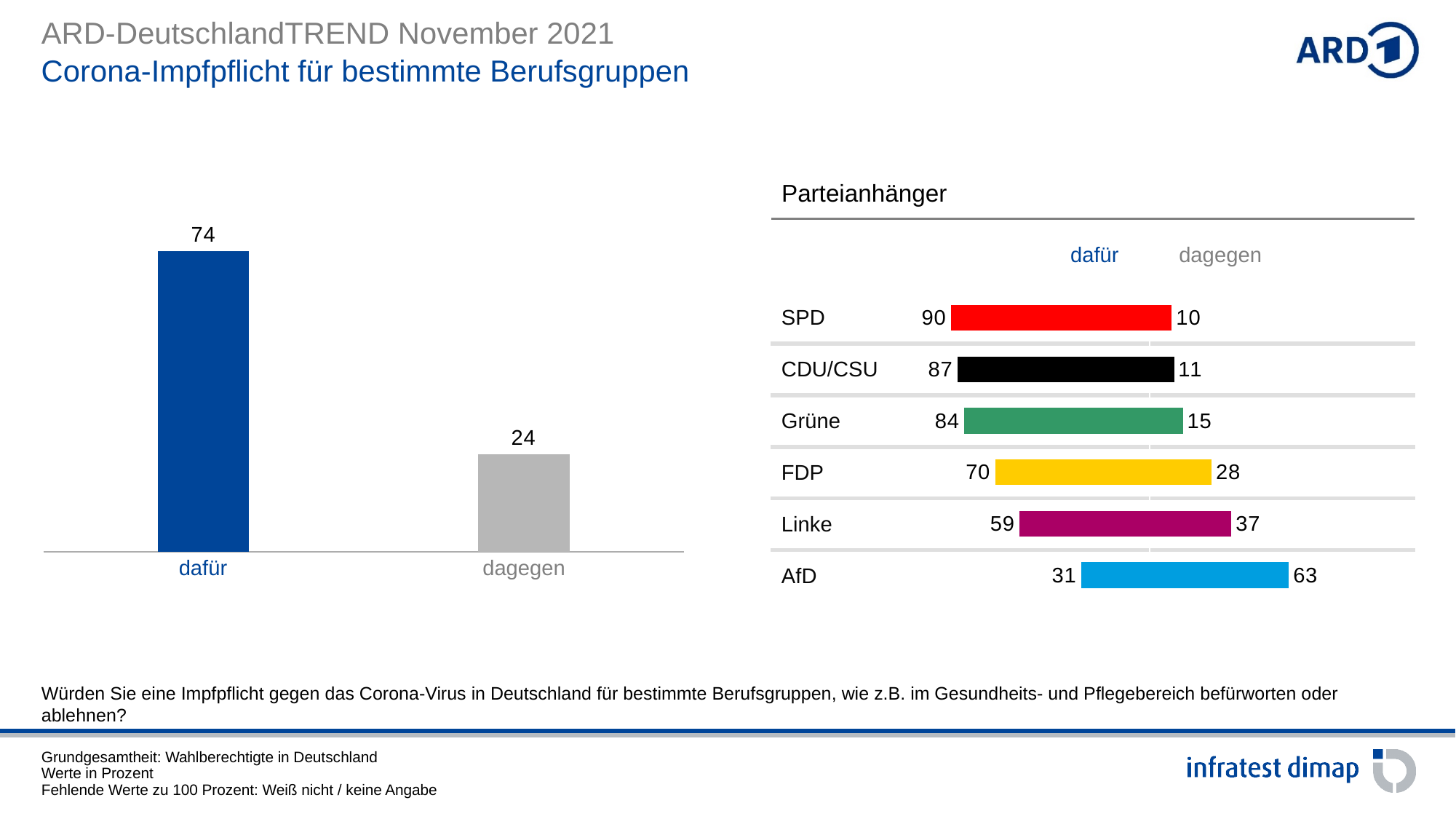
In the 'Parteianhänger' chart, is the 'dafür' value for FDP or for Grüne larger? Grüne In the left bar chart, what is the difference between the 'dafür' and 'dagegen' values? 50 In the 'Parteianhänger' chart, which party has the highest 'dafür' value? SPD What kind of chart is the chart on the left of the slide? bar chart In the 'Parteianhänger' chart, what is the 'dafür' value for SPD? 90 In the 'Parteianhänger' chart, what is the 'dagegen' value for CDU/CSU? 11 In the left bar chart, what is the value for 'dagegen'? 24 In the 'Parteianhänger' chart, which party has the lowest 'dafür' value? AfD In the left bar chart, what is the value for 'dafür'? 74 In the 'Parteianhänger' chart, what is the 'dagegen' value for AfD? 63 In the 'Parteianhänger' chart, what is the difference between the 'dafür' and 'dagegen' values for Linke? 22 How many parties are listed in the 'Parteianhänger' chart? 6